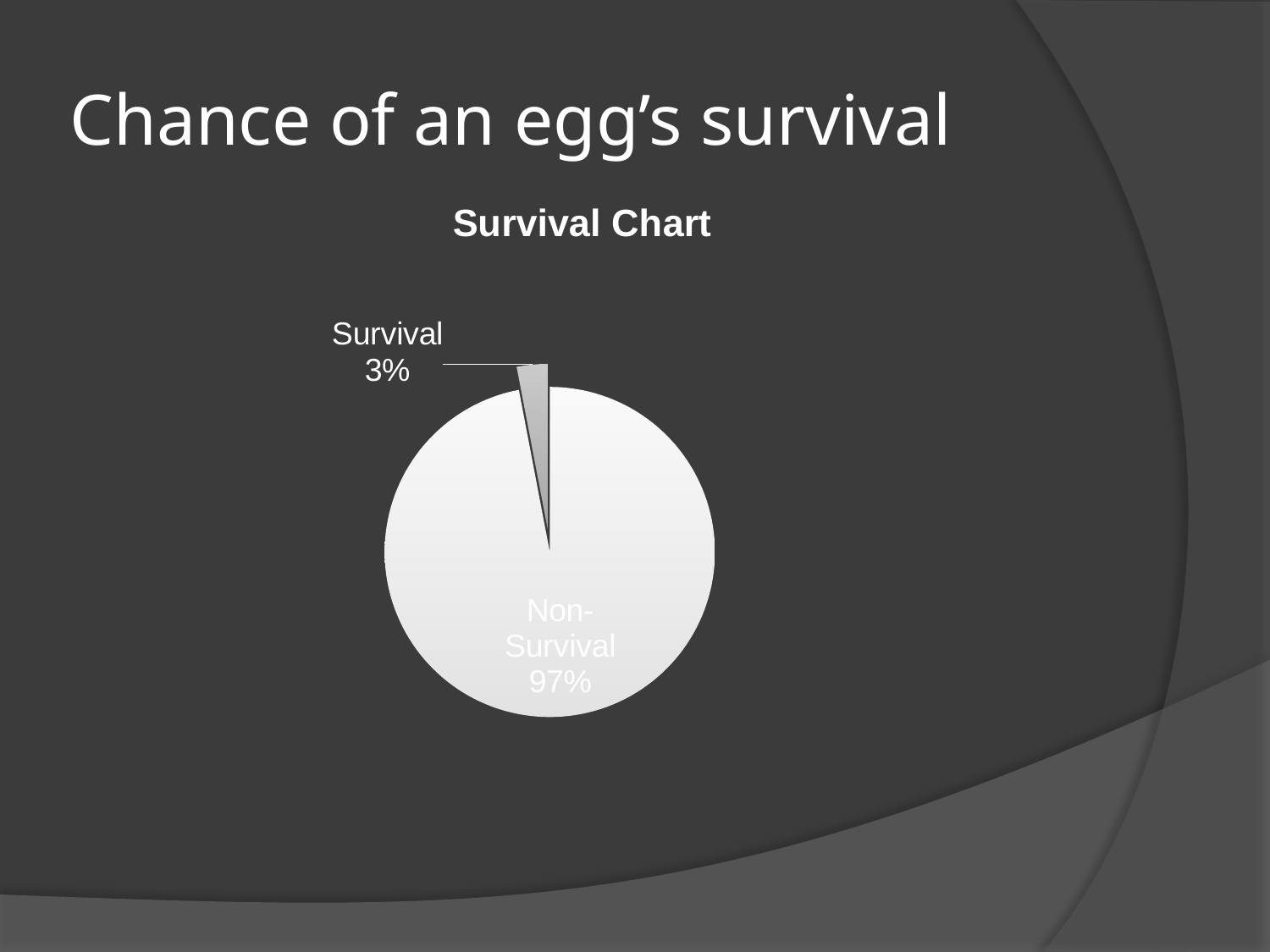
What percentage of the pie is labelled Non-Survival? 97% How many slices does the pie chart have? 2 What is the difference in percentage points between the Non-Survival and Survival slices? 94 What share of the pie does the Survival slice represent? 3% Which slice of the pie is the largest? Non-Survival What is the title of the chart? Survival Chart What percentage of the pie is labelled Survival? 3% Which slice of the pie is the smallest? Survival Which is larger, the Survival slice or the Non-Survival slice? Non-Survival What is the title of the slide? Chance of an egg's survival What kind of chart is shown on the slide? pie chart